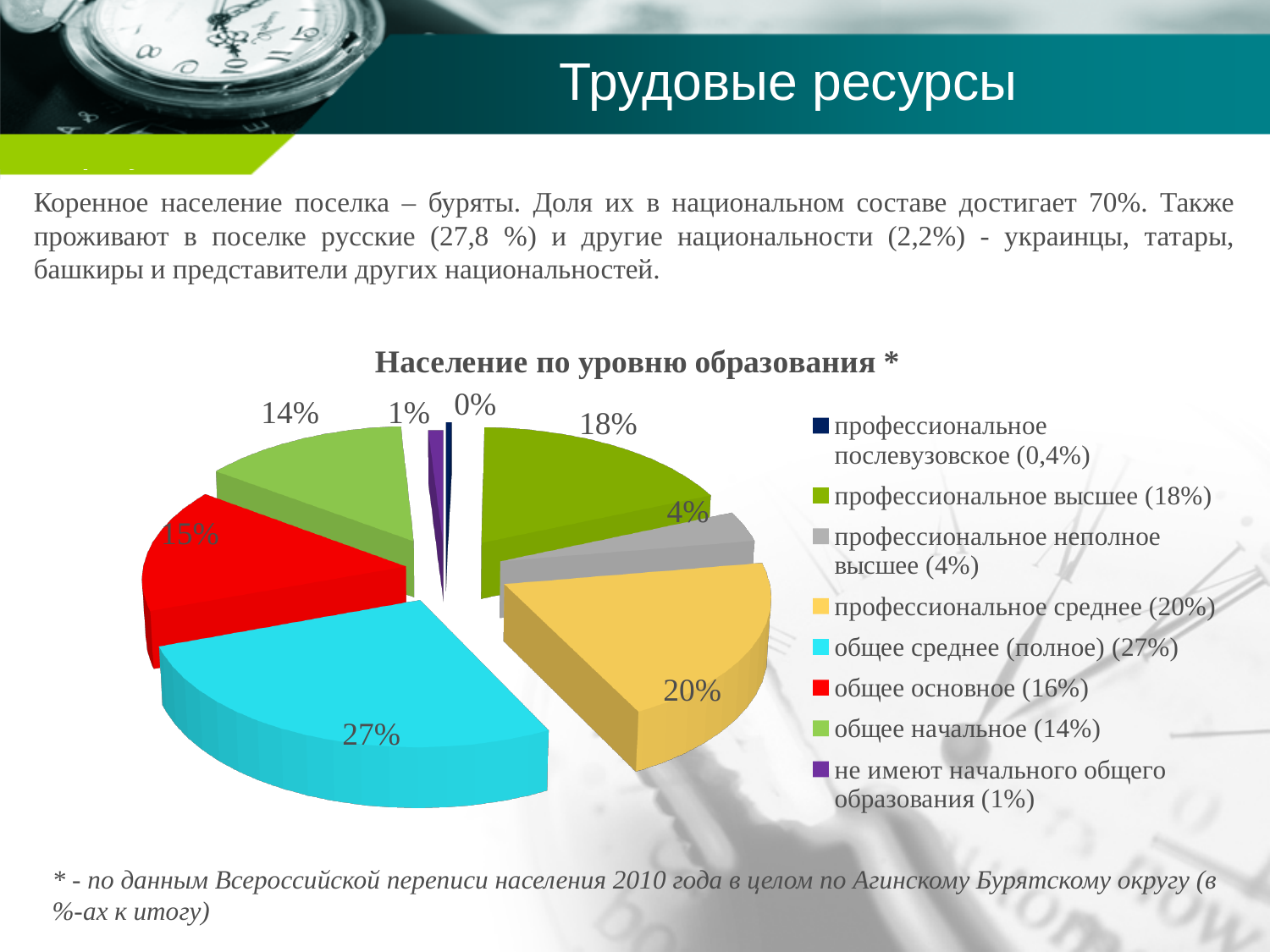
What share of the pie does "общее начальное" have? 14% How many entries does the legend of the pie chart list? 8 Which category has the smallest slice of the pie? профессиональное послевузовское What is the title of the pie chart on the slide? Население по уровню образования * What share of the pie does "профессиональное высшее" have? 18% What share of the pie does "общее среднее (полное)" have? 27% What is the difference between the shares of "общее среднее (полное)" and "профессиональное высшее"? 9% What kind of chart is shown under the title "Население по уровню образования"? pie chart Which is larger: the share of "профессиональное среднее" or the share of "общее начальное"? профессиональное среднее Which category has the largest slice of the pie? общее среднее (полное)